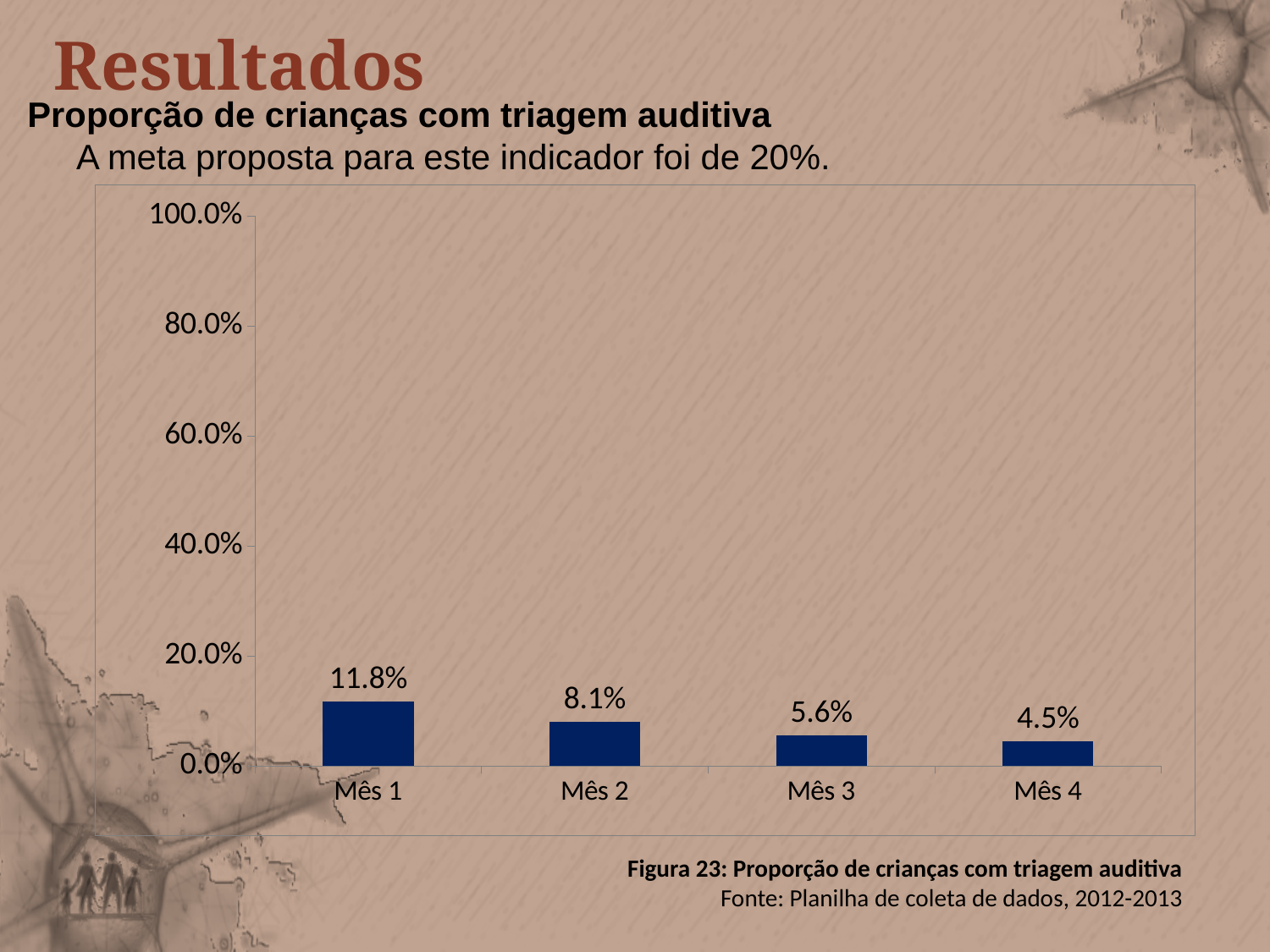
What is the value for Mês 3? 5.6% How many months are shown on the x axis? 4 Is the value for Mês 1 greater or less than 20.0%? less What is the figure caption below the chart? Figura 23: Proporção de crianças com triagem auditiva What is the value for Mês 4? 4.5% What is the value for Mês 1? 11.8% Do the values rise or fall from Mês 1 to Mês 4? fall What kind of chart is shown on the slide? bar chart What is the difference between the values for Mês 1 and Mês 2? 3.7% Which month has the lowest value? Mês 4 Which is larger, the value for Mês 2 or the value for Mês 3? Mês 2 Which month has the highest value? Mês 1